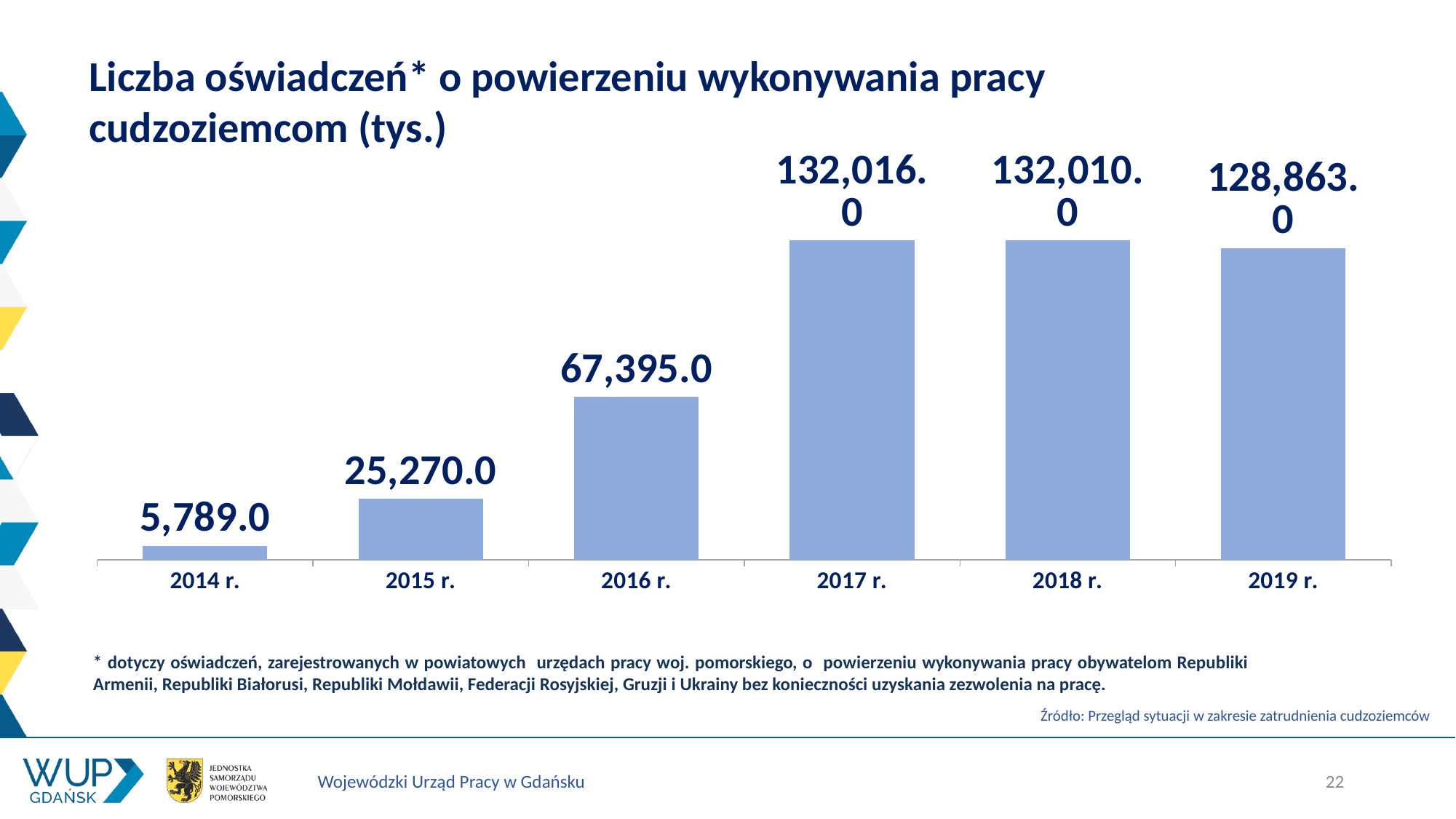
Which year has the highest value? 2017 r. What is the value for 2019 r.? 128,863.0 What kind of chart is shown on the slide? bar chart What is the difference between the values for 2015 r. and 2014 r.? 19,481.0 What is the value for 2014 r.? 5,789.0 What is the value for 2016 r.? 67,395.0 What is the value for 2018 r.? 132,010.0 Which year has the lowest value? 2014 r. How many years are shown on the x axis? 6 What is the difference between the values for 2017 r. and 2016 r.? 64,621.0 Which is larger, the value for 2016 r. or the value for 2015 r.? 2016 r. Do the values rise or fall from 2014 r. to 2017 r.? rise